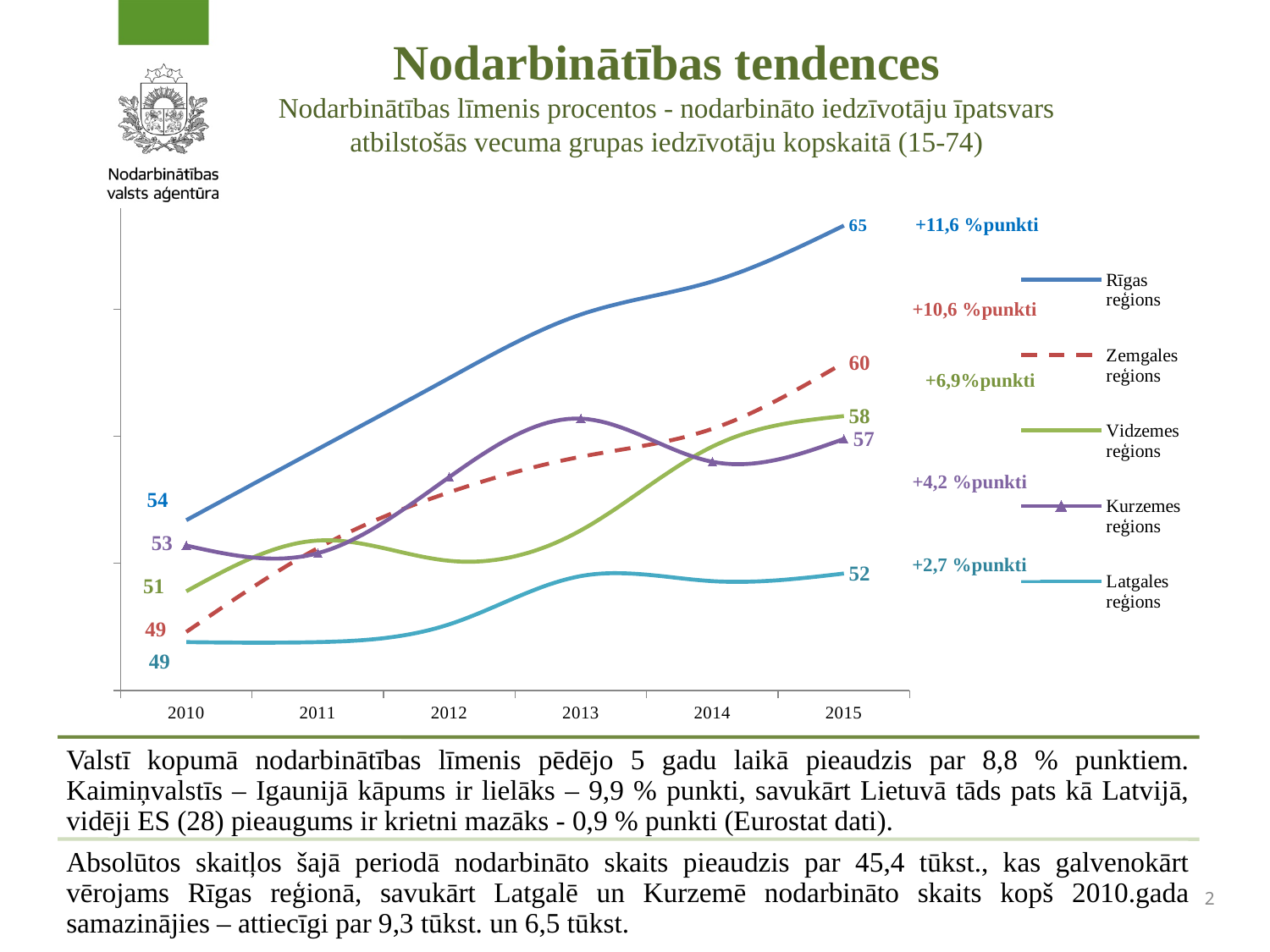
How many series does the legend list? 5 Which is larger in 2015, the value for Vidzemes reģions or Kurzemes reģions? Vidzemes reģions Does the Rīgas reģions line rise or fall from 2010 to 2015? rise What kind of chart is shown on the slide? line chart What is the value for Rīgas reģions in 2015? 65 Which region has the lowest value in 2015? Latgales reģions What is the value for Zemgales reģions in 2015? 60 What is the difference between the Rīgas reģions values in 2015 and 2010? 11,6 How many years are shown on the x axis? 6 What is the value for Latgales reģions in 2015? 52 What is the value for Rīgas reģions in 2010? 54 Which region has the highest value in 2015? Rīgas reģions